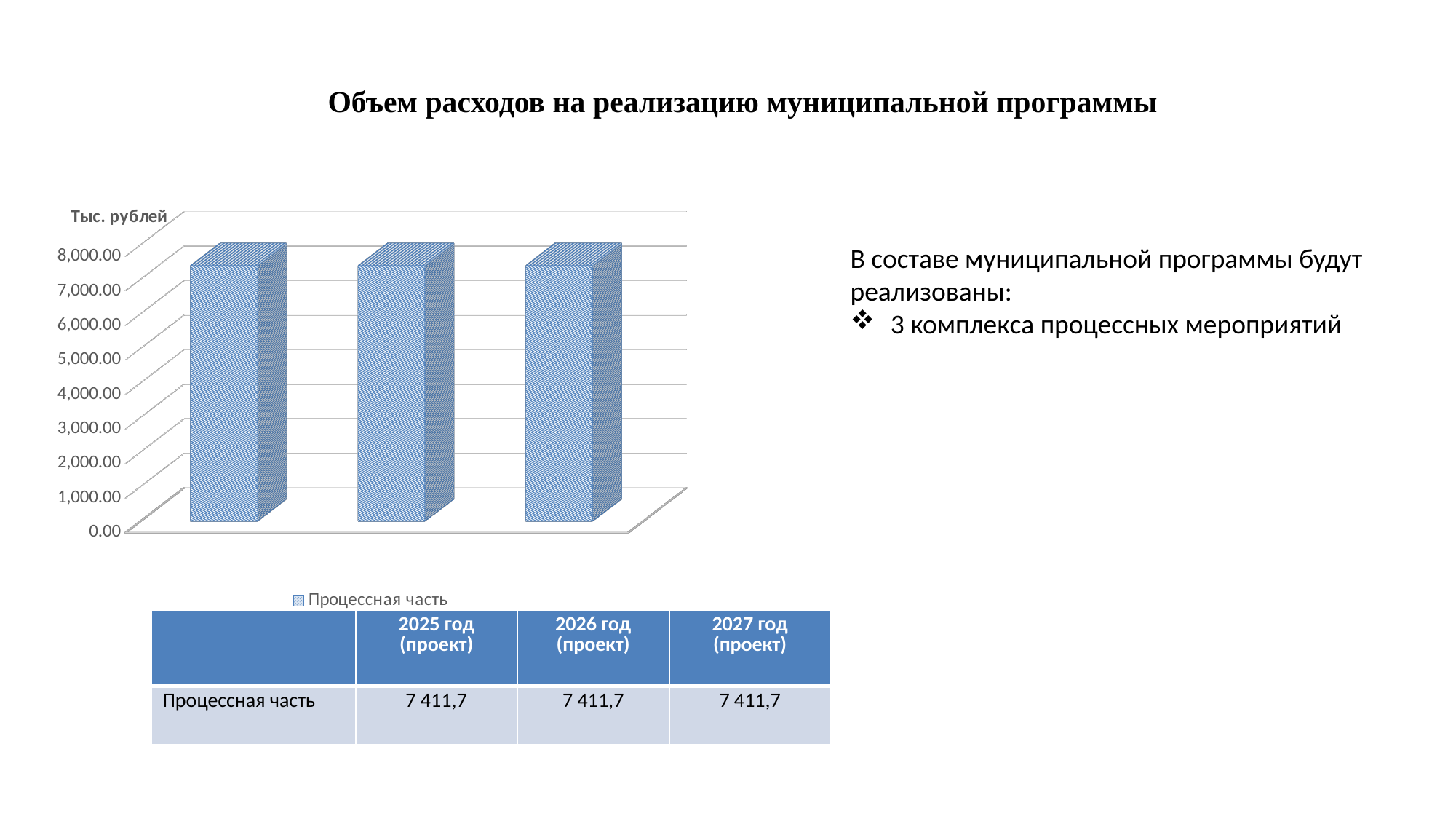
Do the bar values rise, fall, or stay the same from left to right? stay the same How many bars are plotted in the chart? 3 What is the name of the series shown in the chart legend? Процессная часть How many series does the chart legend list? 1 Is the value of the second bar greater or less than 6,000.00? greater What kind of chart is shown on the slide? bar chart According to the table under the chart, what is the value of Процессная часть for 2027 год (проект)? 7 411,7 What is the title of the chart on the slide? Объем расходов на реализацию муниципальной программы Is the value of the first bar greater or less than 7,000.00? greater Is the value of the third bar greater or less than 8,000.00? less According to the table under the chart, what is the value of Процессная часть for 2025 год (проект)? 7 411,7 What is the difference between the Процессная часть values for 2026 год (проект) and 2025 год (проект) shown in the table? 0